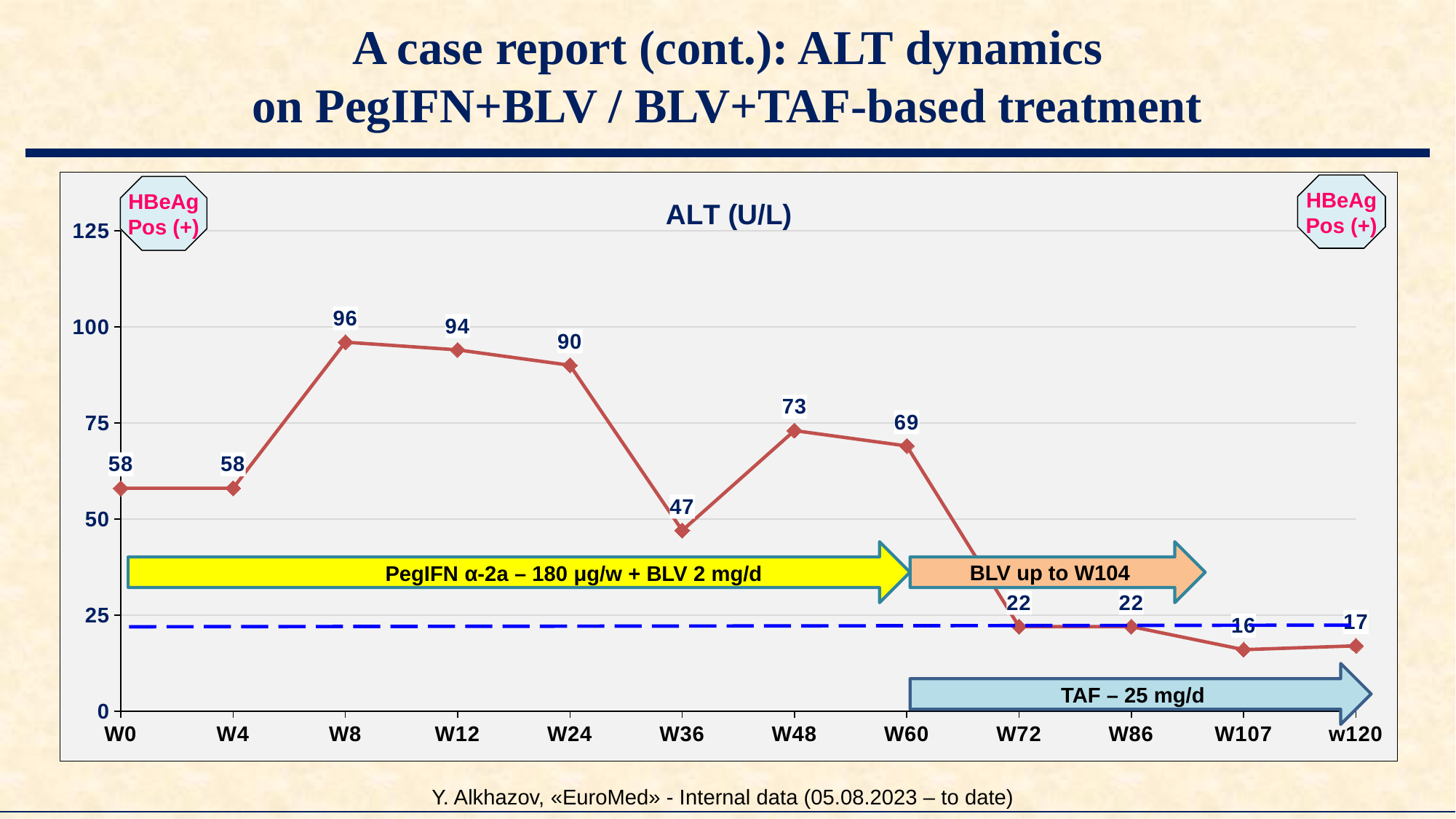
What is the ALT value at W36? 47 What kind of chart is shown on the slide? line chart Which is larger, the ALT value at W48 or at W60? W48 At which week is the ALT value lowest? W107 What is the ALT value at w120? 17 What is the difference between the ALT values at W8 and W36? 49 What is the title of the chart? ALT (U/L) How many time points are plotted on the x axis? 12 What is the ALT value at W8? 96 At which week is the ALT value highest? W8 Do the ALT values rise or fall from W60 to W72? fall Is the ALT value at W24 greater or less than 75? greater